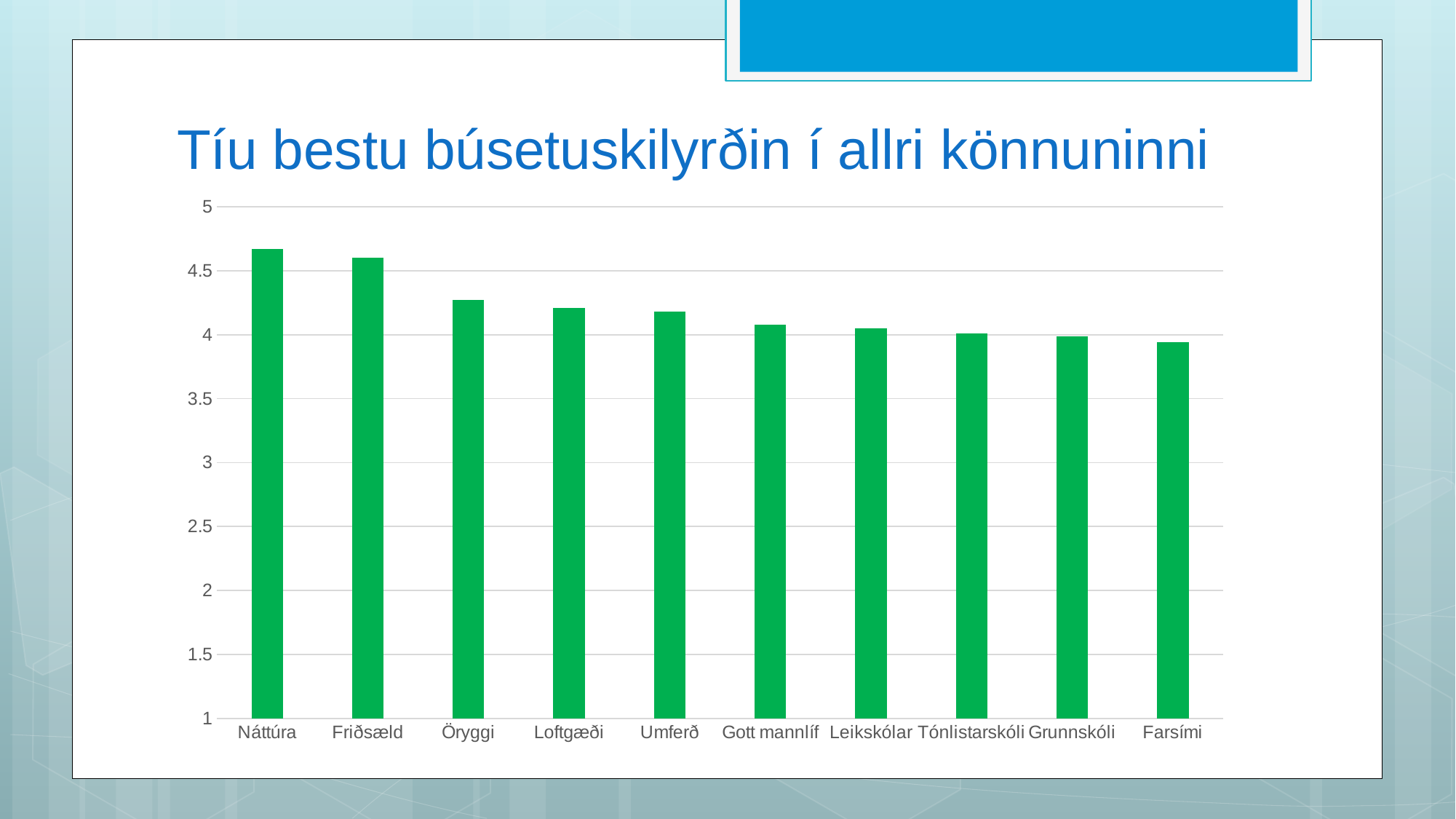
Which category has the highest value? Náttúra Is the value for Náttúra greater or less than 4.5? greater How many categories are plotted on the chart? 10 Is the value for Umferð greater or less than 4? greater Which is larger, the value for Náttúra or the value for Öryggi? Náttúra What is the title of the chart? Tíu bestu búsetuskilyrðin í allri könnuninni What colour are the bars in the chart? green What kind of chart is shown on the slide? bar chart Do the values rise or fall from left to right along the x axis? fall Which is larger, the value for Loftgæði or the value for Friðsæld? Friðsæld Is the value for Öryggi greater or less than 4.5? less